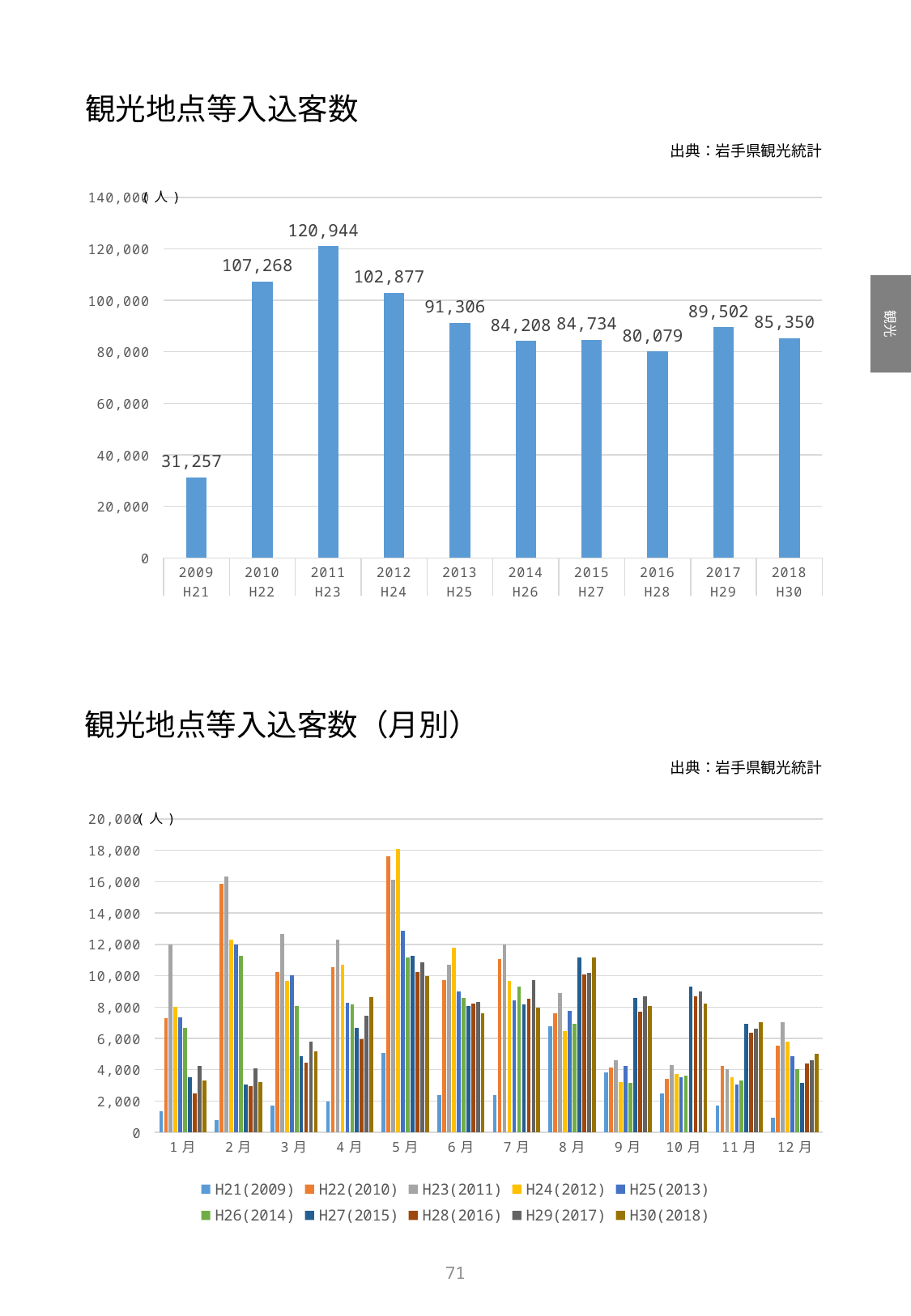
In the bottom chart (観光地点等入込客数（月別）), how many series does the legend list? 10 In the top chart (観光地点等入込客数), which year has the lowest value? 2009 (H21) In the top chart (観光地点等入込客数), which is larger, the value for 2013 or the value for 2017? 2013 In the top chart (観光地点等入込客数), what is the value for 2011 (H23)? 120,944 In the top chart (観光地点等入込客数), what is the difference between the values for 2011 and 2010? 13,676 In the bottom chart (観光地点等入込客数（月別）), is the value for H22(2010) in 5月 greater or less than 16,000? greater In the top chart (観光地点等入込客数), which year has the highest value? 2011 (H23) In the top chart (観光地点等入込客数), what is the difference between the values for 2017 and 2018? 4,152 In the top chart (観光地点等入込客数), what is the value for 2016 (H28)? 80,079 What kind of chart is the top chart (観光地点等入込客数)? bar chart In the top chart (観光地点等入込客数), how many years are plotted? 10 In the bottom chart (観光地点等入込客数（月別）), is the value for H21(2009) in 1月 greater or less than 2,000? less